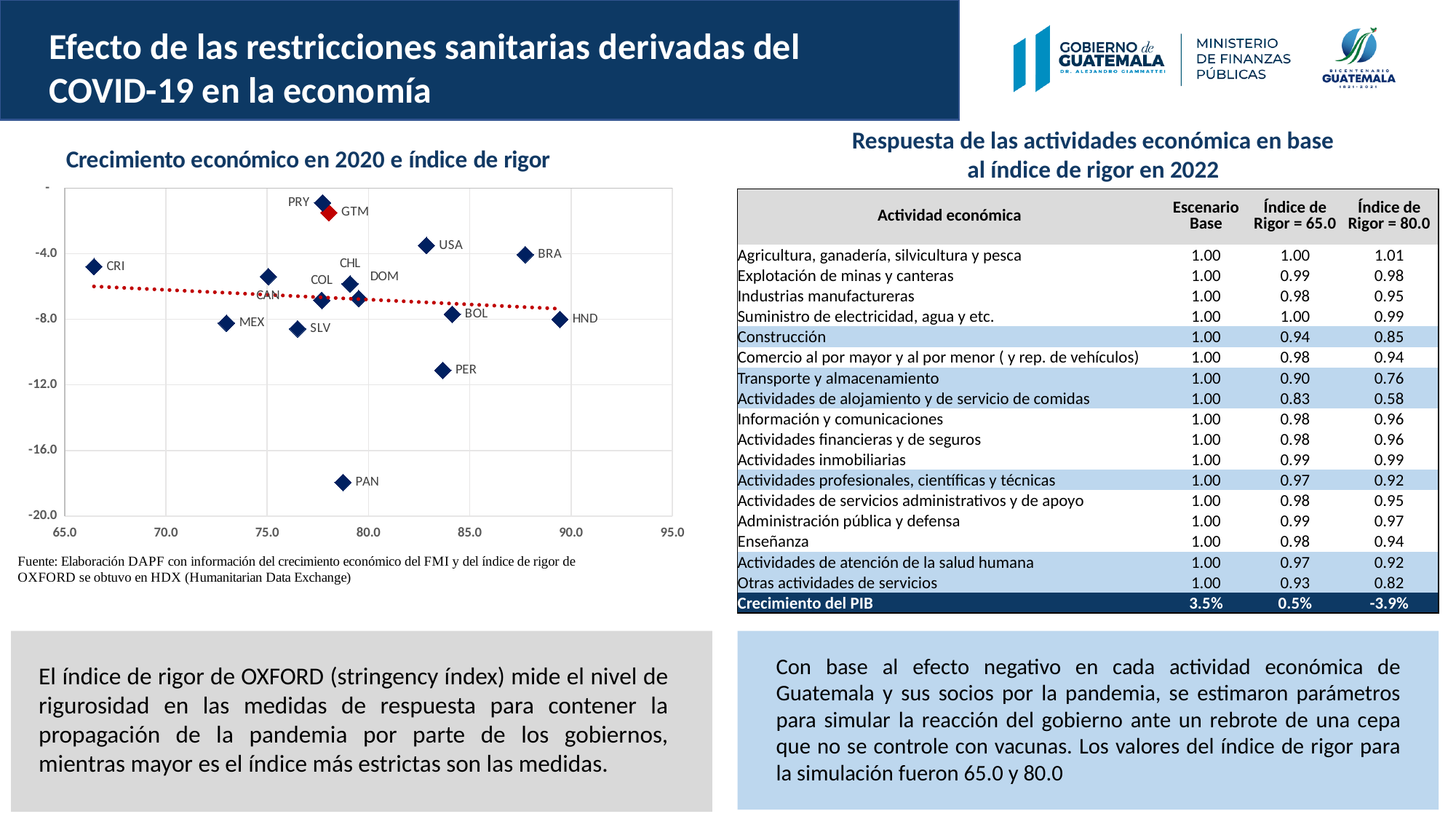
Which country has the lowest economic growth value in the scatter chart? PAN Which country is plotted furthest to the left (lowest stringency index) in the scatter chart? CRI Which has the higher growth value in the scatter chart, BRA or BOL? BRA Is the growth value for CRI greater or less than -8.0? greater Which country's point is highlighted in red in the scatter chart? GTM Which has the higher growth value in the scatter chart, USA or PER? USA Does the dotted trend line in the scatter chart rise or fall as the stringency index increases? Falls Is the stringency index value for HND greater or less than 85.0? greater What kind of chart is shown under the title "Crecimiento económico en 2020 e índice de rigor"? Scatter chart Is the growth value for PER greater or less than -8.0? less